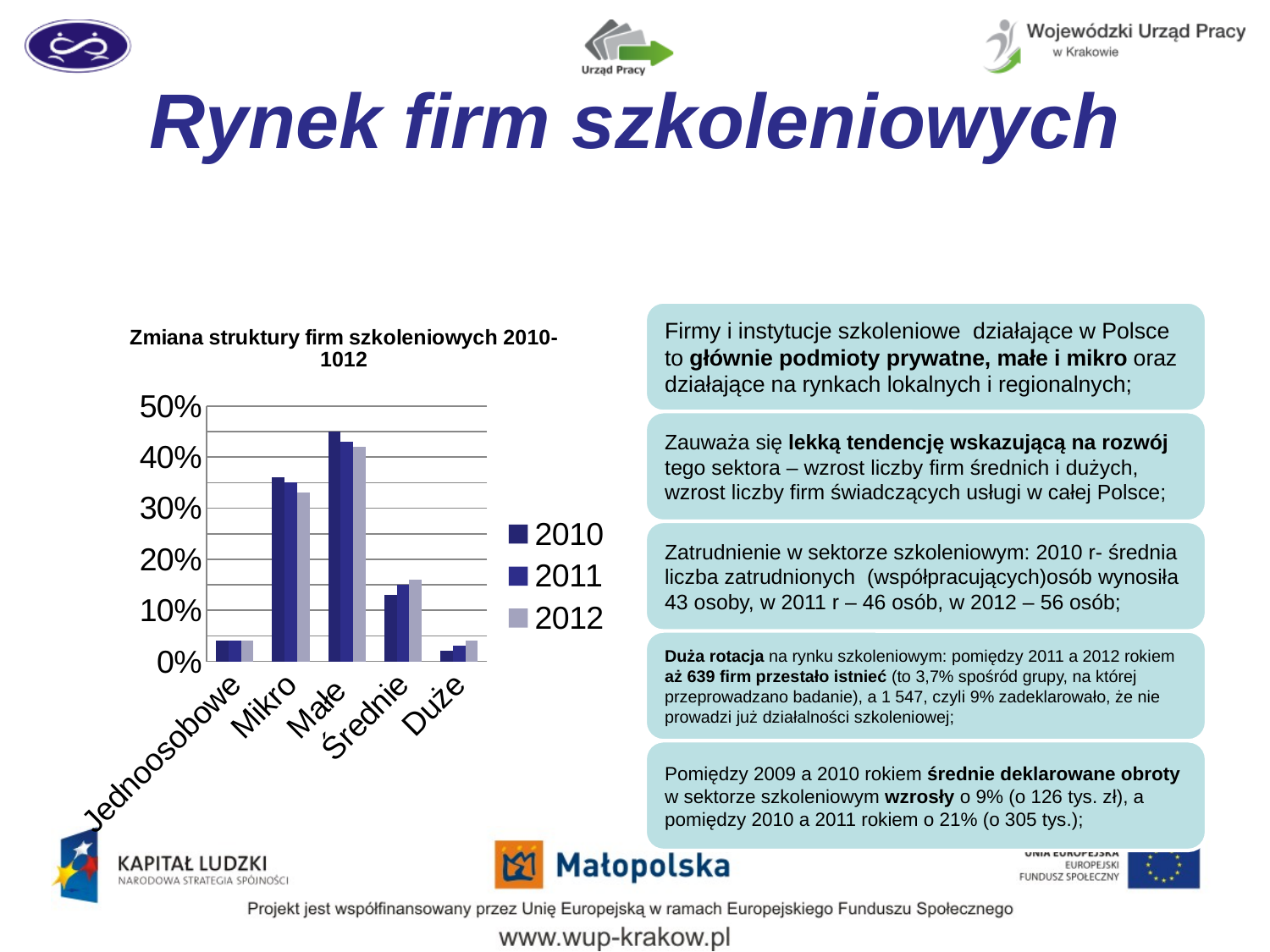
Is the value for Jednoosobowe in 2011 greater or less than 10%? less Is the value for Małe in 2010 greater or less than 40%? greater What kind of chart is shown on the slide? bar chart How many series does the chart legend list? 3 What is the title of the chart? Zmiana struktury firm szkoleniowych 2010-1012 Which category has the lowest value for 2010? Duże Is the value for Mikro in 2012 greater or less than 30%? greater Which category has the highest value for 2010? Małe Do the values for Mikro rise or fall from 2010 to 2012? fall Which is larger for 2011: Mikro or Średnie? Mikro How many categories are shown on the x axis of the chart? 5